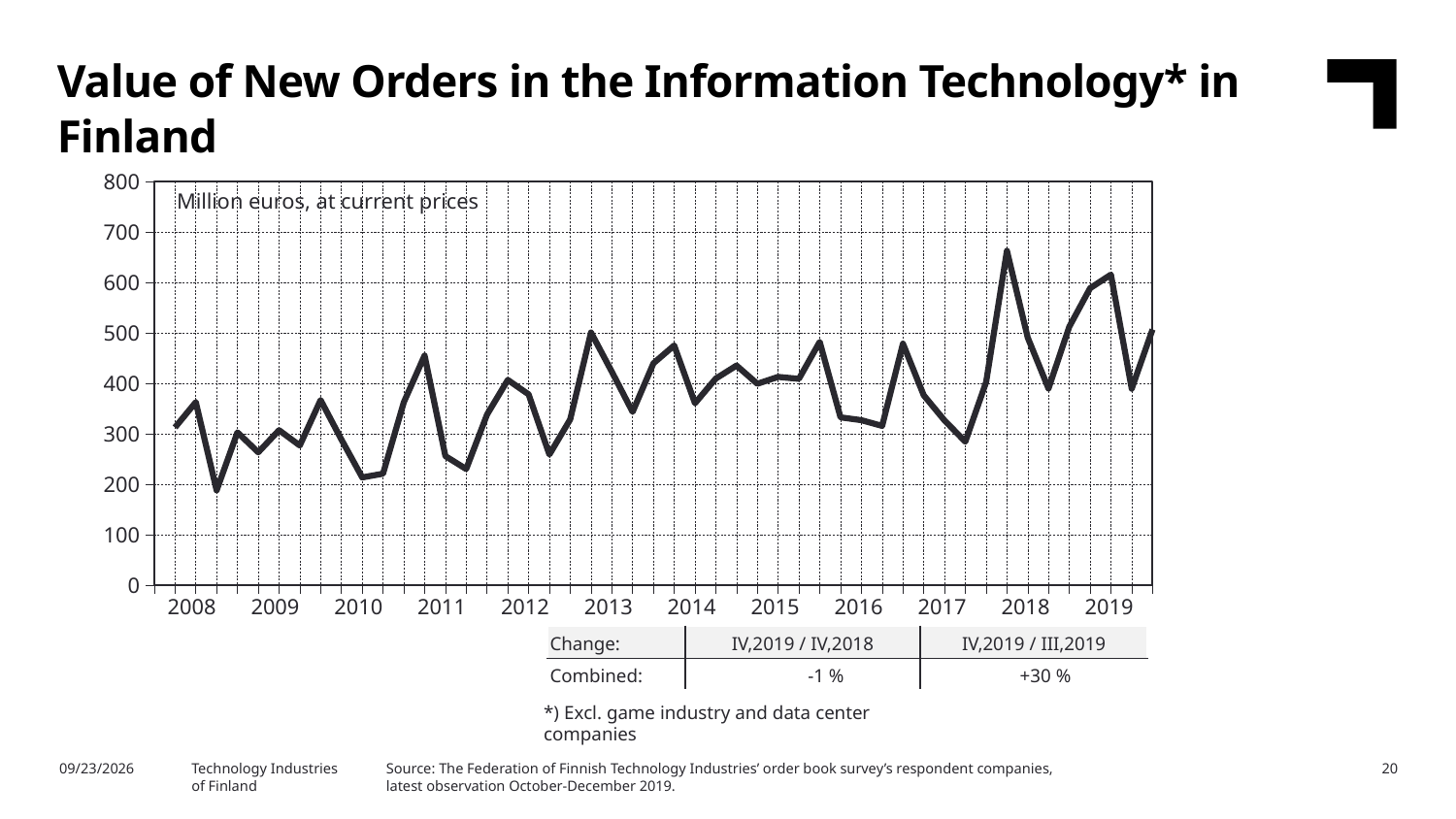
How many years are labelled on the x axis? 12 What kind of chart is shown on the slide? line chart What is the combined change for IV,2019 / IV,2018 shown in the table below the chart? -1 % In what unit are the values on the chart expressed? Million euros, at current prices What is the title of the chart? Value of New Orders in the Information Technology* in Finland Is the lowest point of the line, in 2008, greater or less than 200? less Comparing the first point in 2008 with the last point in 2019, does the line end higher or lower than it started? higher Is the peak value reached in 2011 greater or less than 400? greater What is the combined change for IV,2019 / III,2019 shown in the table below the chart? +30 % Is the highest point of the line greater or less than 600? greater What is the highest value shown on the y axis? 800